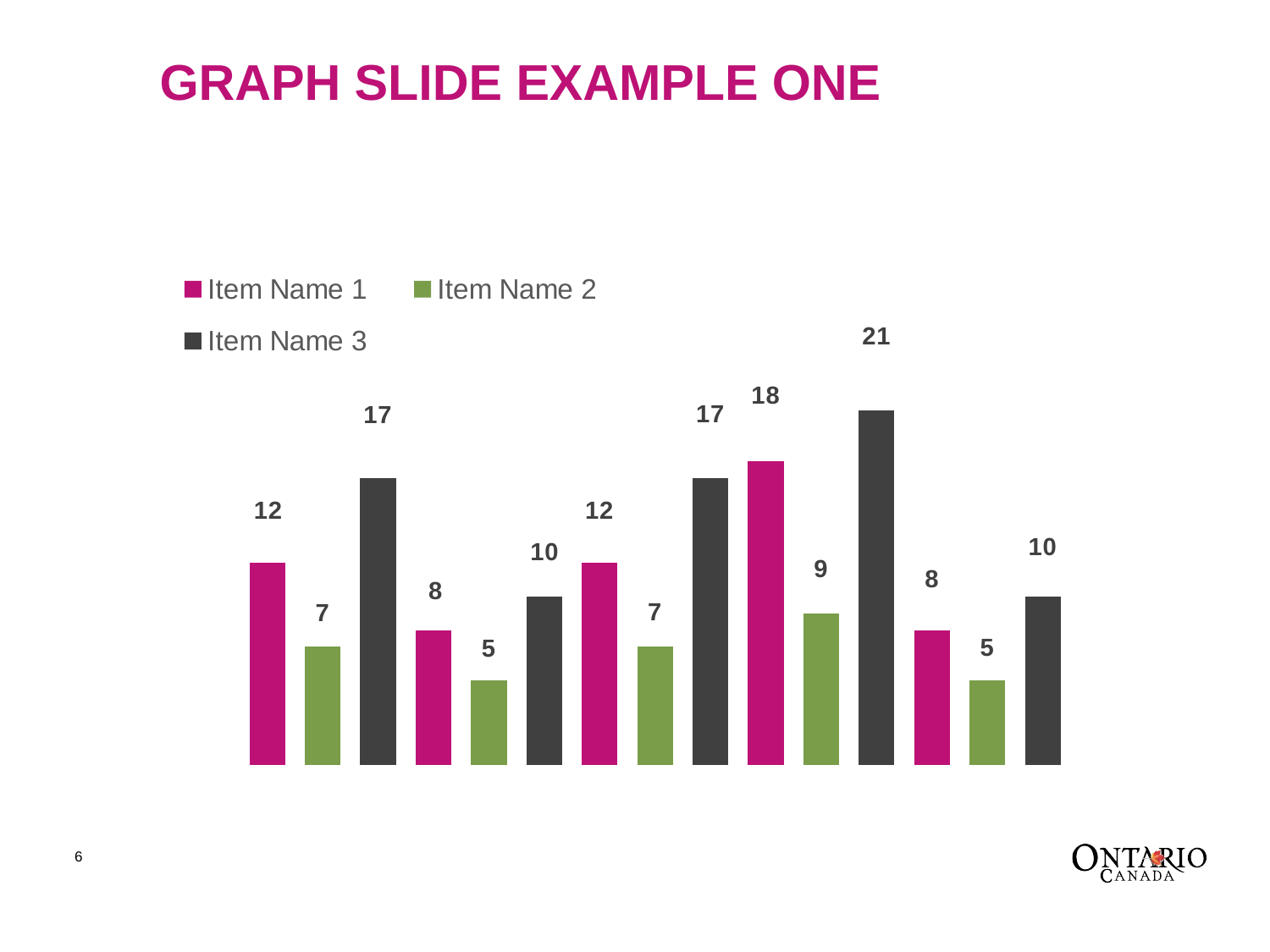
Which series has the highest value in the fourth group of bars from the left? Item Name 3 What is the value of Item Name 1 in the first group of bars from the left? 12 What kind of chart is shown on the slide? bar chart In the second group of bars from the left, which is larger: Item Name 1 or Item Name 3? Item Name 3 What is the difference between Item Name 3 and Item Name 1 in the fourth group of bars from the left? 3 What is the value of Item Name 3 in the fourth group of bars from the left? 21 How many groups of bars are plotted along the x axis? 5 What colour are the bars for Item Name 2? green What is the highest value shown anywhere on the chart? 21 What is the value of Item Name 2 in the second group of bars from the left? 5 How many series does the legend list? 3 Which series has the lowest value in the first group of bars from the left? Item Name 2